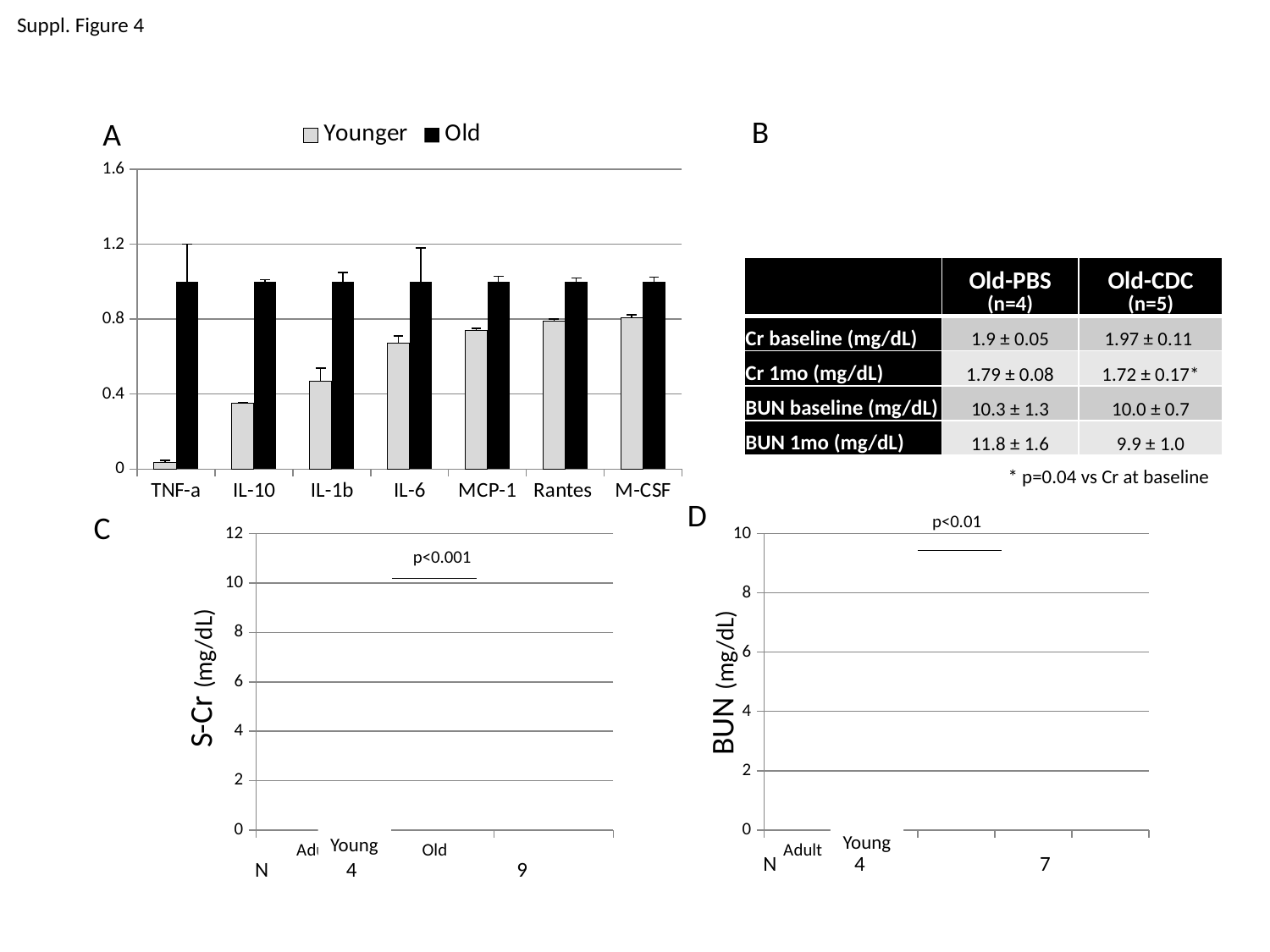
In chart A, which is larger for TNF-a, the Younger value or the Old value? Old In chart D, what is the y-axis label? BUN (mg/dL) In chart A, is the Younger value for IL-10 greater or less than 0.4? less In chart A, do the Younger values rise or fall from TNF-a to M-CSF along the x axis? rise In chart A, is the Younger value for IL-6 greater or less than 0.4? greater In chart A, what are the two legend entries? Younger and Old In chart C, what is the N shown for the Old group? 9 In chart A, which category has the lowest Younger value? TNF-a In chart A, how many series does the legend list? 2 What kind of chart is chart A? Bar chart In chart A, is the Old value for MCP-1 greater or less than 0.8? greater In chart A, how many categories are shown on the x axis? 7